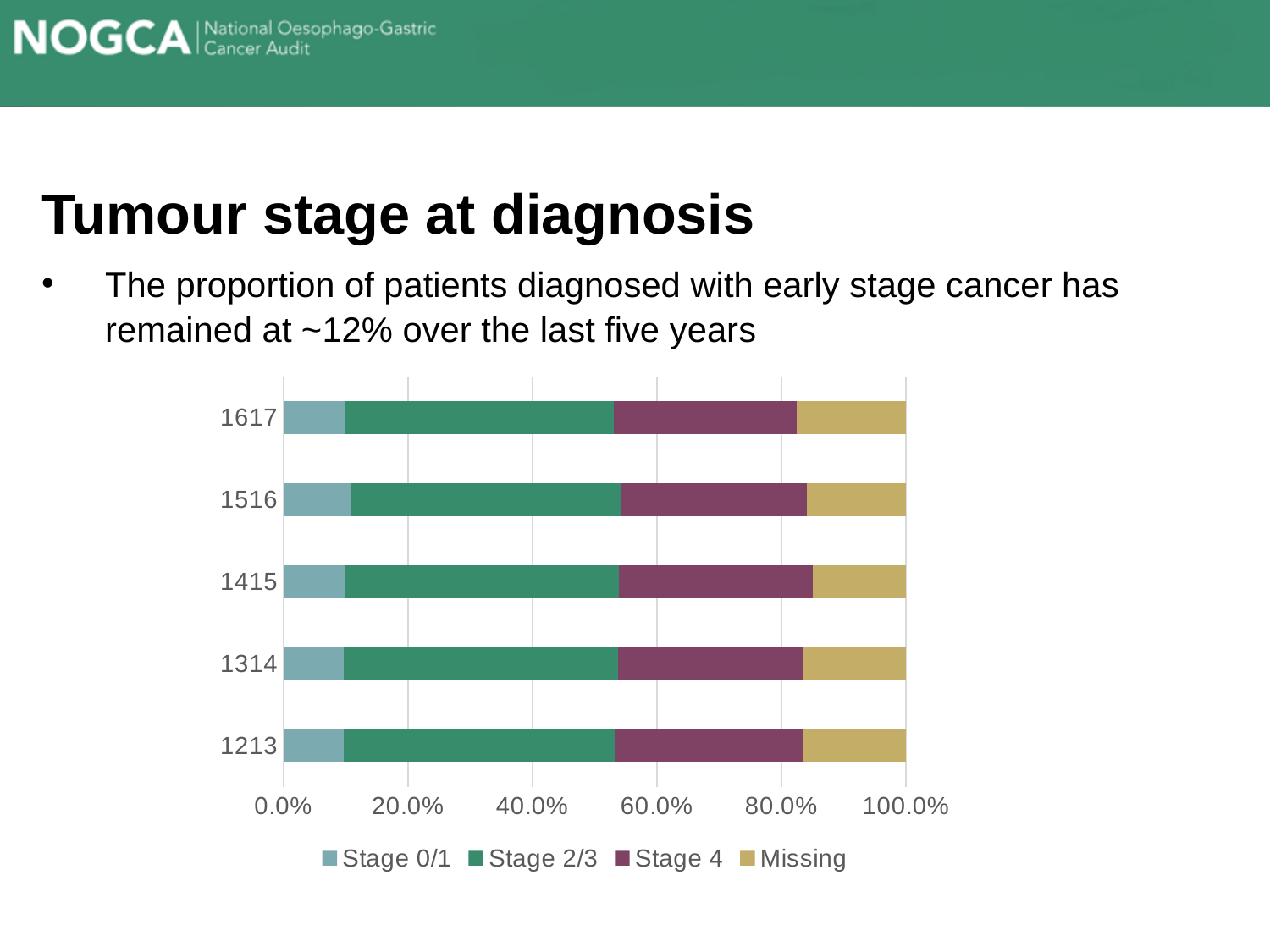
What are the series names listed in the chart legend? Stage 0/1, Stage 2/3, Stage 4, Missing How many year categories are shown on the chart? 5 Which year category appears at the top of the chart? 1617 Which series has the smallest segment in the 1617 bar? Stage 0/1 Is the Stage 4 value for 1213 greater or less than 20.0%? greater Which series has the largest segment in the 1213 bar? Stage 2/3 Is the Stage 0/1 value for 1617 greater or less than 20.0%? less What is the total of the stacked bar for 1617? 100.0% In the 1516 bar, which is larger: the Stage 2/3 segment or the Stage 4 segment? Stage 2/3 How many series does the chart legend list? 4 Is the Missing value for 1415 greater or less than 20.0%? less What kind of chart is shown on the slide? Stacked bar chart